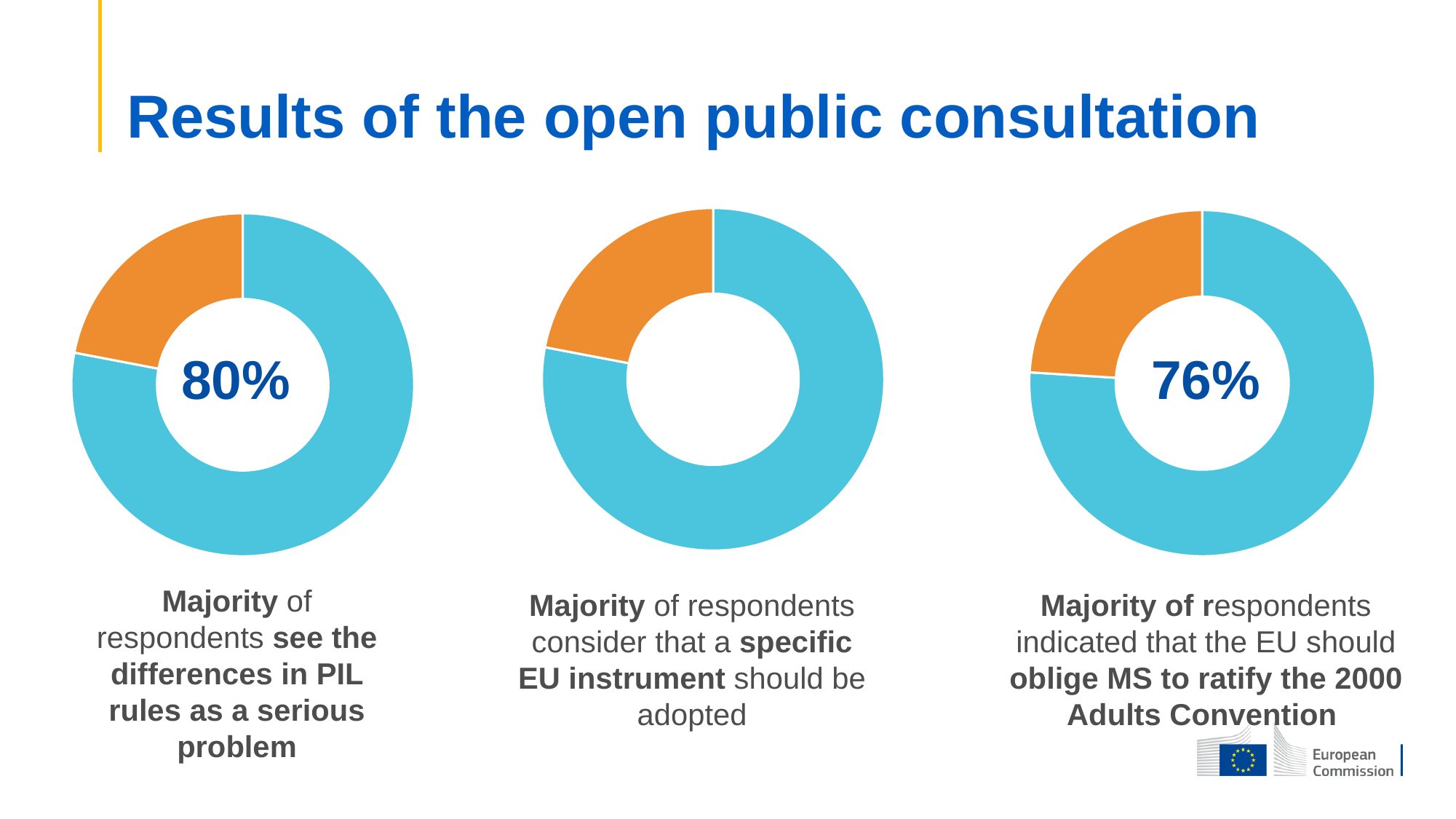
What is the difference between the percentage on the left chart and the percentage on the right chart? 4 percentage points What colour is the larger slice in each donut chart? Blue On the right donut chart, what percentage is shown in the centre? 76% How many donut charts are on the slide? 3 On the left donut chart, what percentage is shown in the centre? 80% What kind of chart is used on this slide? Donut (pie) chart How many slices does the left donut chart have? 2 On the middle donut chart, which slice is larger, the blue one or the orange one? The blue one On the right donut chart, what share does the orange slice represent? 24% What is the title of the slide? Results of the open public consultation Which chart shows the higher percentage, the left chart (serious problem) or the right chart (ratify the 2000 Adults Convention)? The left chart (80%)